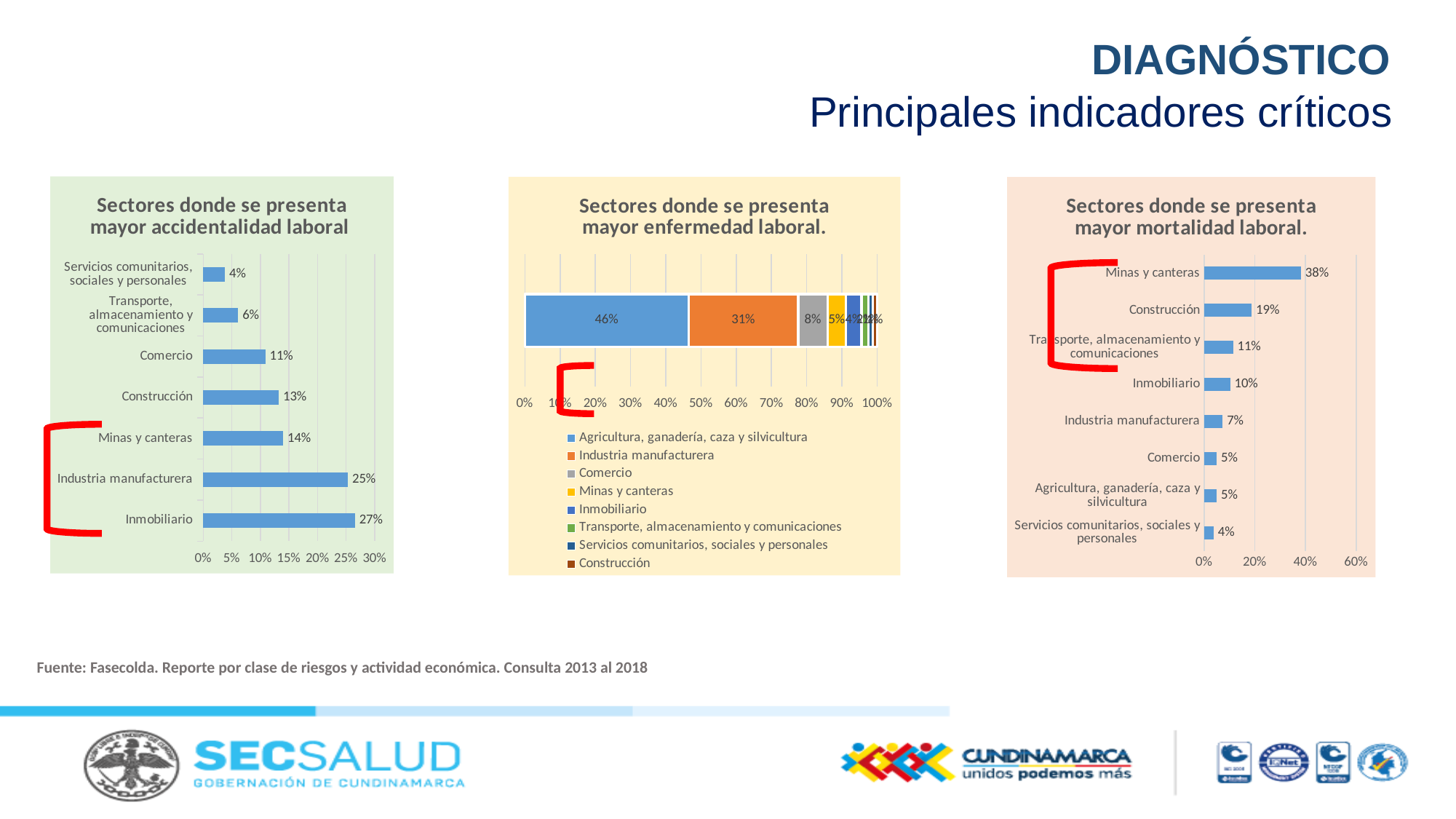
In the chart 'Sectores donde se presenta mayor mortalidad laboral', is the value for Minas y canteras greater or less than 20%? greater In the chart 'Sectores donde se presenta mayor mortalidad laboral', which is larger: Inmobiliario or Industria manufacturera? Inmobiliario In the chart 'Sectores donde se presenta mayor enfermedad laboral', what is the value for Industria manufacturera? 31% How many series does the legend list in the chart 'Sectores donde se presenta mayor enfermedad laboral'? 8 In the chart 'Sectores donde se presenta mayor mortalidad laboral', which sector has the highest value? Minas y canteras In the chart 'Sectores donde se presenta mayor accidentalidad laboral', what is the difference between Industria manufacturera and Construcción? 12% In the chart 'Sectores donde se presenta mayor enfermedad laboral', what is the value for Agricultura, ganadería, caza y silvicultura? 46% In the chart 'Sectores donde se presenta mayor accidentalidad laboral', what is the value for Inmobiliario? 27% In the chart 'Sectores donde se presenta mayor accidentalidad laboral', which sector has the lowest value? Servicios comunitarios, sociales y personales What kind of chart is 'Sectores donde se presenta mayor enfermedad laboral'? Stacked bar chart In the chart 'Sectores donde se presenta mayor mortalidad laboral', what is the value for Construcción? 19% How many sectors are shown in the chart 'Sectores donde se presenta mayor accidentalidad laboral'? 7